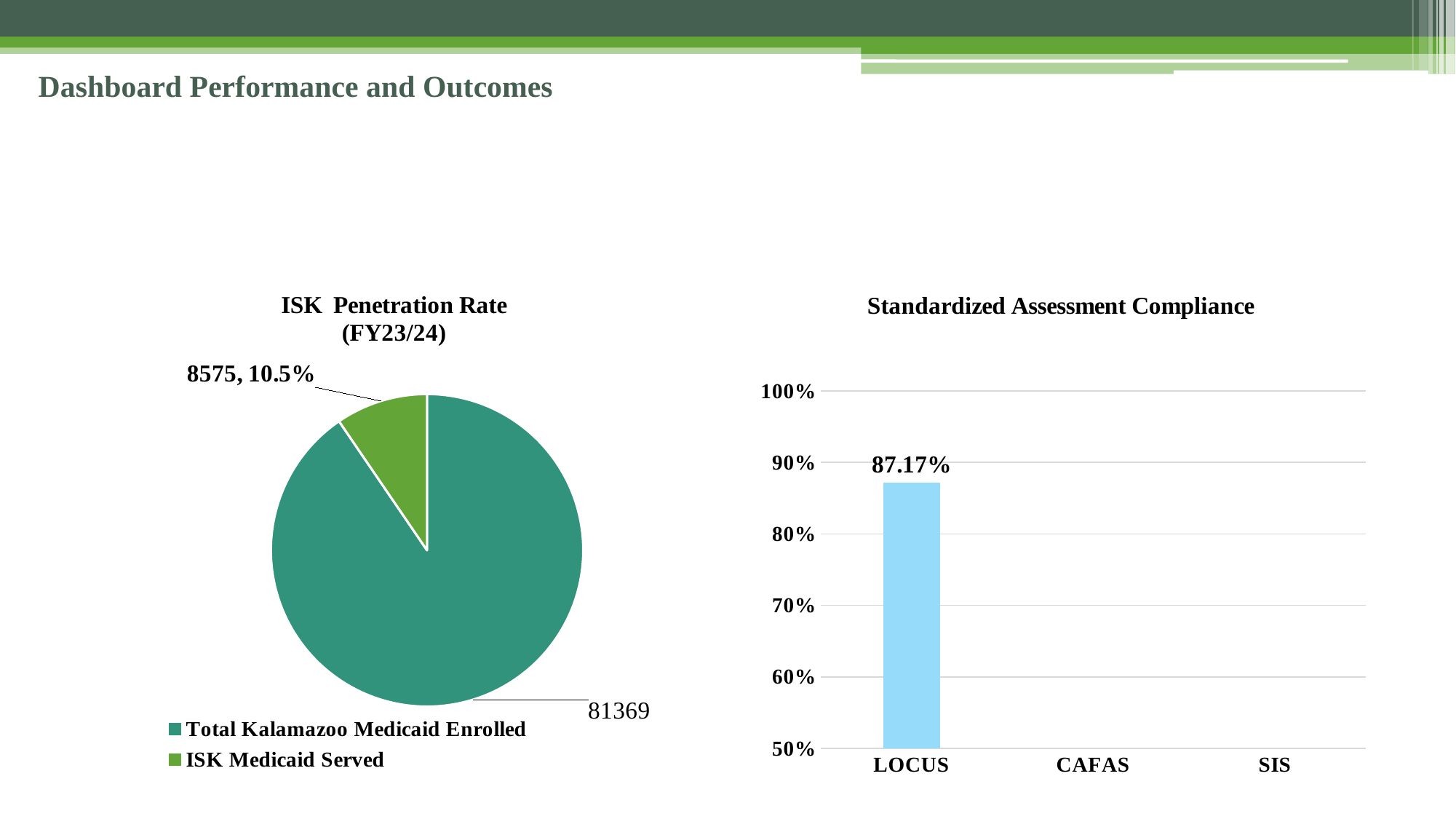
In the ISK Penetration Rate (FY23/24) chart, what value is shown for ISK Medicaid Served? 8575 In the ISK Penetration Rate (FY23/24) chart, which slice is larger: Total Kalamazoo Medicaid Enrolled or ISK Medicaid Served? Total Kalamazoo Medicaid Enrolled What kind of chart is the ISK Penetration Rate (FY23/24) chart? Pie chart How many categories are labelled on the x axis of the Standardized Assessment Compliance chart? 3 In the Standardized Assessment Compliance chart, which category has the only bar plotted? LOCUS What kind of chart is the Standardized Assessment Compliance chart? Bar chart In the ISK Penetration Rate (FY23/24) chart, what value is shown for Total Kalamazoo Medicaid Enrolled? 81369 How many series does the legend of the ISK Penetration Rate (FY23/24) chart list? 2 In the ISK Penetration Rate (FY23/24) chart, what is the difference between Total Kalamazoo Medicaid Enrolled and ISK Medicaid Served? 72794 In the Standardized Assessment Compliance chart, is the value for LOCUS greater or less than 80%? greater In the Standardized Assessment Compliance chart, what is the value for LOCUS? 87.17% In the ISK Penetration Rate (FY23/24) chart, what share of the pie is ISK Medicaid Served? 10.5%